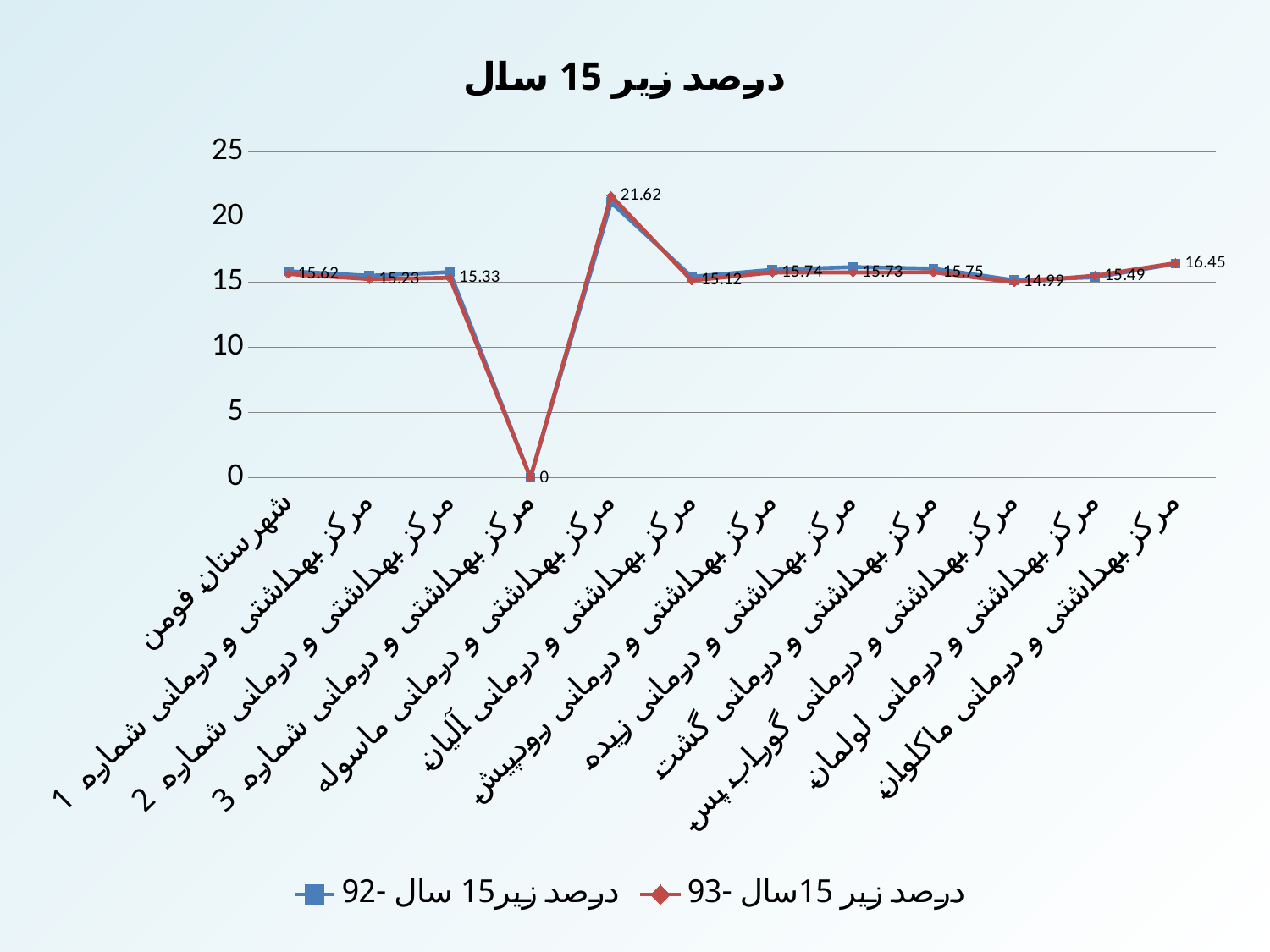
What is the title of the chart? درصد زیر 15 سال What value is labelled for مرکز بهداشتی و درمانی ماکلوان? 16.45 What kind of chart is shown on the slide? line chart How many categories are shown along the x axis? 12 What value is labelled for مرکز بهداشتی و درمانی ماسوله? 21.62 Which category has the highest value? مرکز بهداشتی و درمانی ماسوله How many series does the legend list? 2 What value is labelled for شهرستان فومن? 15.62 What is the difference between the labelled values for مرکز بهداشتی و درمانی آلیان and مرکز بهداشتی و درمانی ماکلوان? 1.33 Is the value for مرکز بهداشتی و درمانی آلیان greater or less than 20? less Which category has the lowest value? مرکز بهداشتی و درمانی شماره 3 What value is labelled for مرکز بهداشتی و درمانی آلیان? 15.12